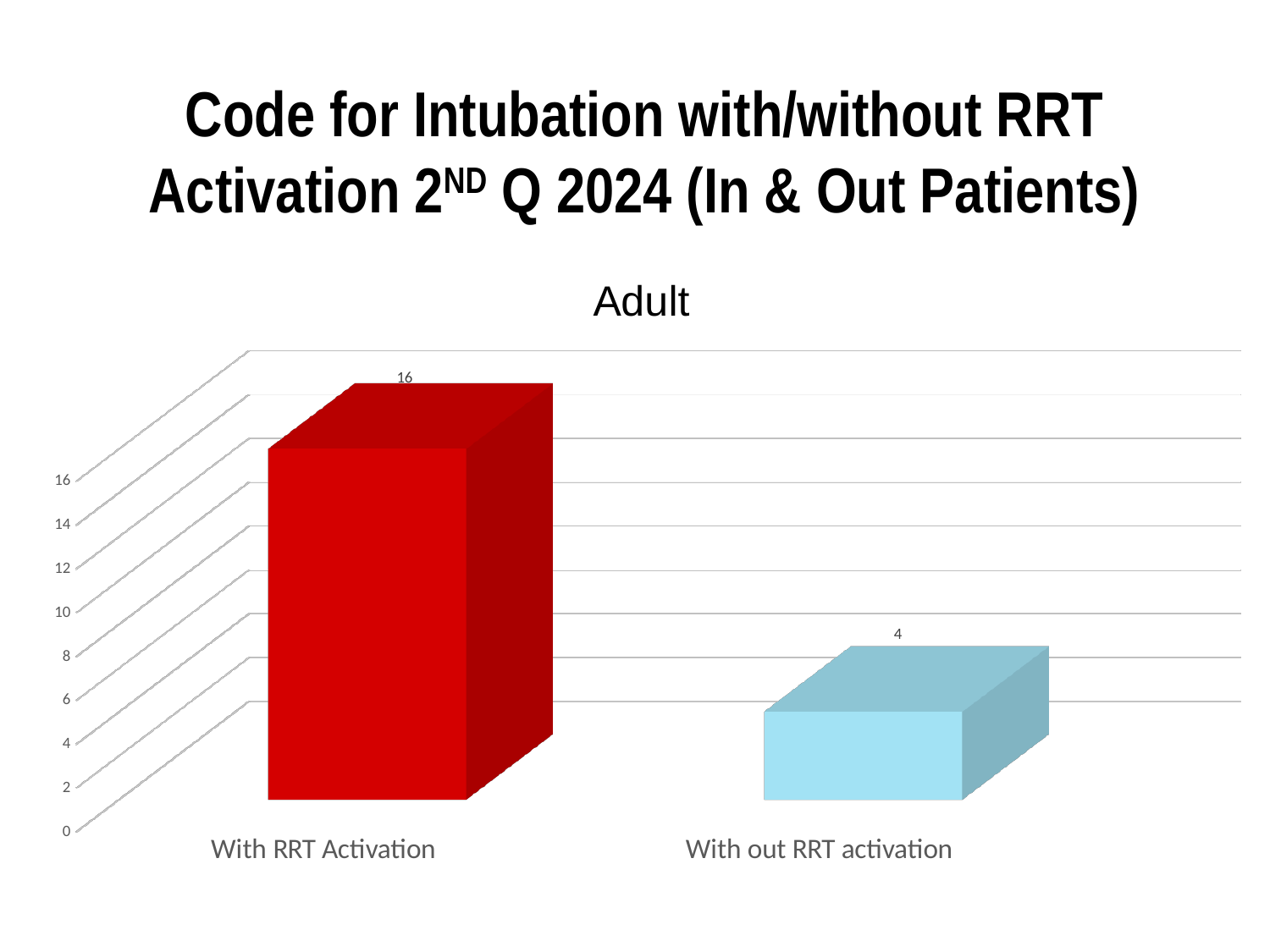
Which category has the highest value? With RRT Activation How many categories are shown on the chart? 2 What is the title of the chart? Adult Is the value for With RRT Activation greater or less than 10? greater What is the value for With RRT Activation? 16 What kind of chart is shown on the slide? bar chart Which is larger, the value for With RRT Activation or the value for With out RRT activation? With RRT Activation Is the value for With out RRT activation greater or less than 10? less What is the difference between the values for With RRT Activation and With out RRT activation? 12 What colour is the bar for With RRT Activation? red What is the value for With out RRT activation? 4 Which category has the lowest value? With out RRT activation